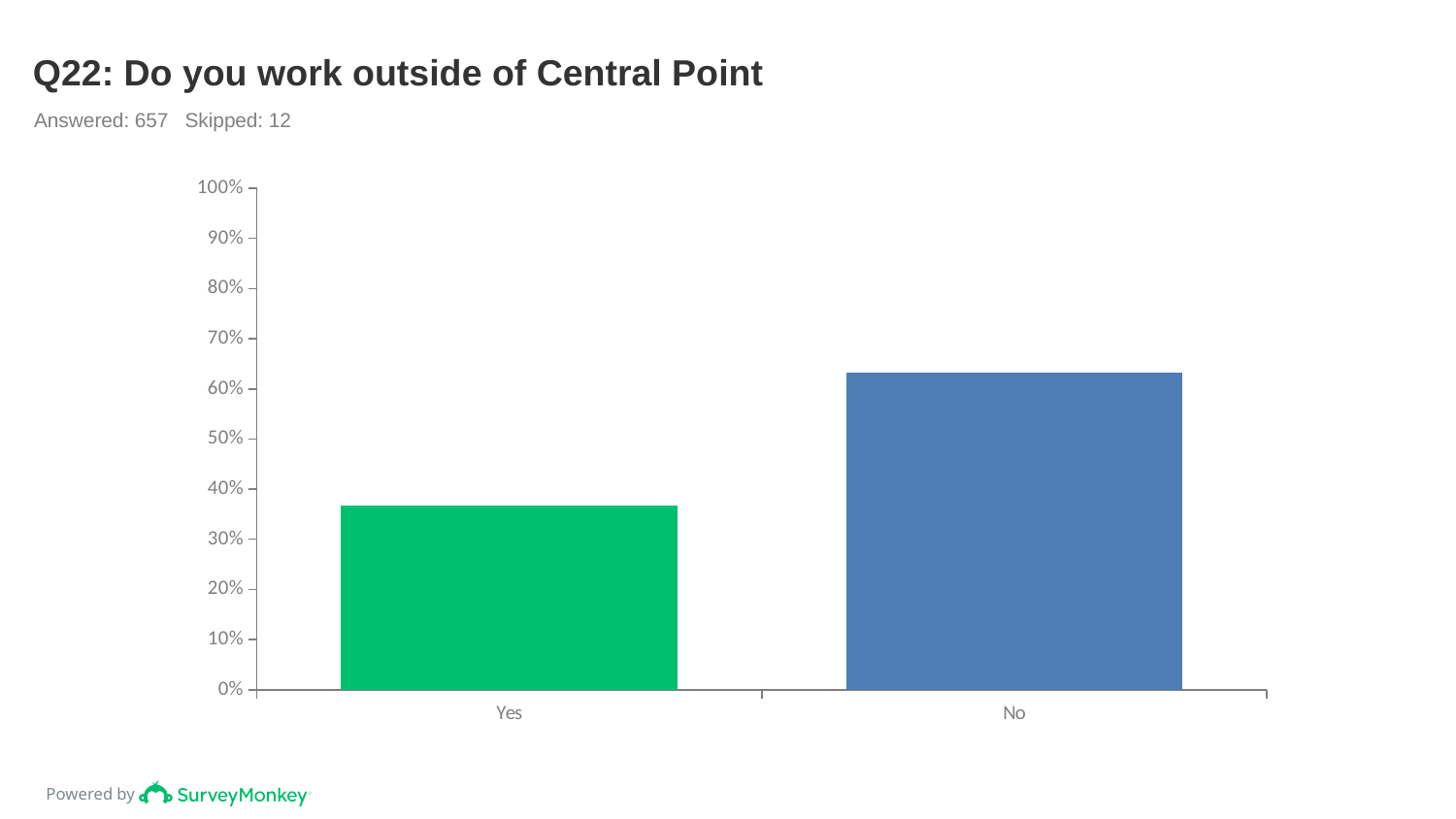
Is the value for Yes greater or less than 30%? greater Is the value for No greater or less than 60%? greater What is the title of the chart? Q22: Do you work outside of Central Point Which is larger, the value for Yes or the value for No? No Is the value for No greater or less than 70%? less What kind of chart is shown on the slide? bar chart How many categories are shown on the x axis? 2 Which category has the lowest value? Yes What colour is the bar for Yes? green Which category has the highest value? No What is the highest value shown on the y axis? 100%